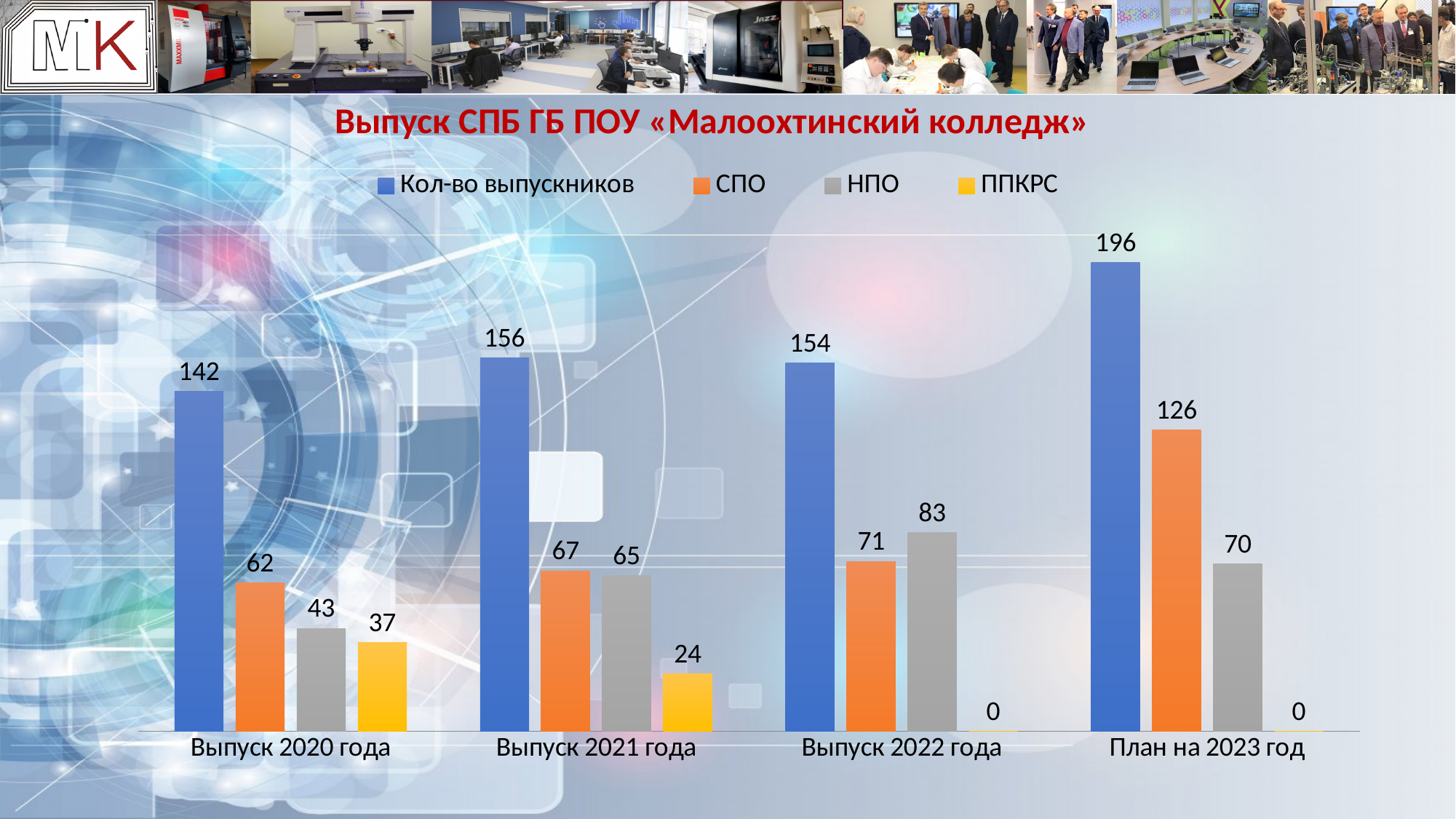
What is the value of СПО for План на 2023 год? 126 Which category has the highest value for Кол-во выпускников? План на 2023 год Which is larger: НПО for Выпуск 2021 года or НПО for План на 2023 год? План на 2023 год Which category has the lowest value for СПО? Выпуск 2020 года What kind of chart is shown on the slide? Bar chart What is the value of НПО for Выпуск 2022 года? 83 How many series does the legend list? 4 What is the difference between Кол-во выпускников for План на 2023 год and for Выпуск 2022 года? 42 How many categories are shown on the x axis? 4 What is the title of the chart? Выпуск СПБ ГБ ПОУ «Малоохтинский колледж» What is the value of Кол-во выпускников for Выпуск 2020 года? 142 What is the value of ППКРС for Выпуск 2021 года? 24